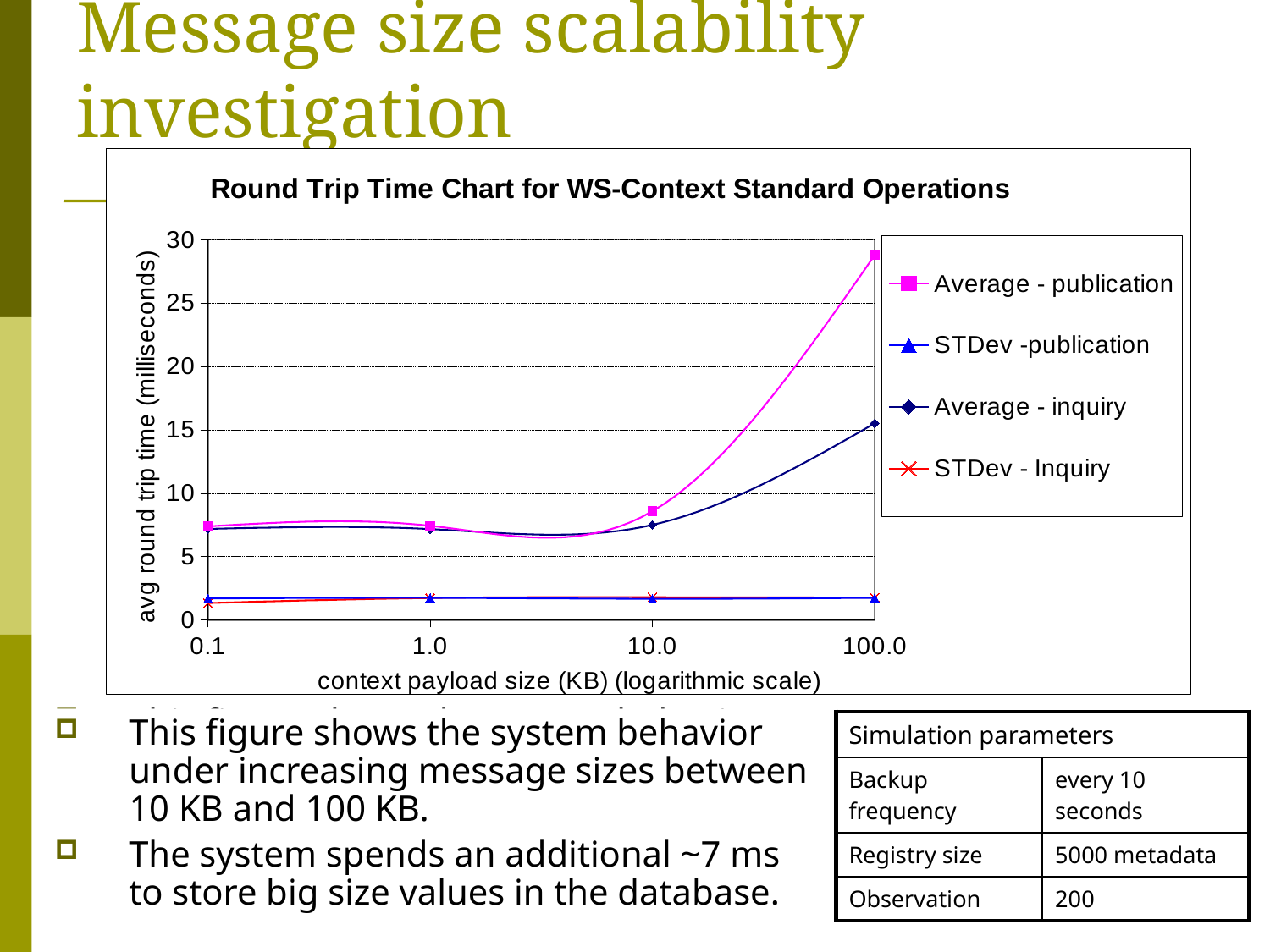
What kind of chart is shown on the slide? line chart How many context payload size values are plotted along the x axis? 4 Is the value for Average - inquiry at 100.0 KB greater or less than 10? greater At 100.0 KB, which is larger: Average - inquiry or STDev - Inquiry? Average - inquiry How many series does the legend of the chart list? 4 Is the value for STDev -publication at 0.1 KB greater or less than 5? less At 100.0 KB, which is larger: Average - publication or Average - inquiry? Average - publication Is the value for Average - publication at 100.0 KB greater or less than 25? greater What is the title of the chart? Round Trip Time Chart for WS-Context Standard Operations Which series has the highest value at a context payload size of 100.0 KB? Average - publication Does the Average - publication series rise or fall between 10.0 KB and 100.0 KB? rise